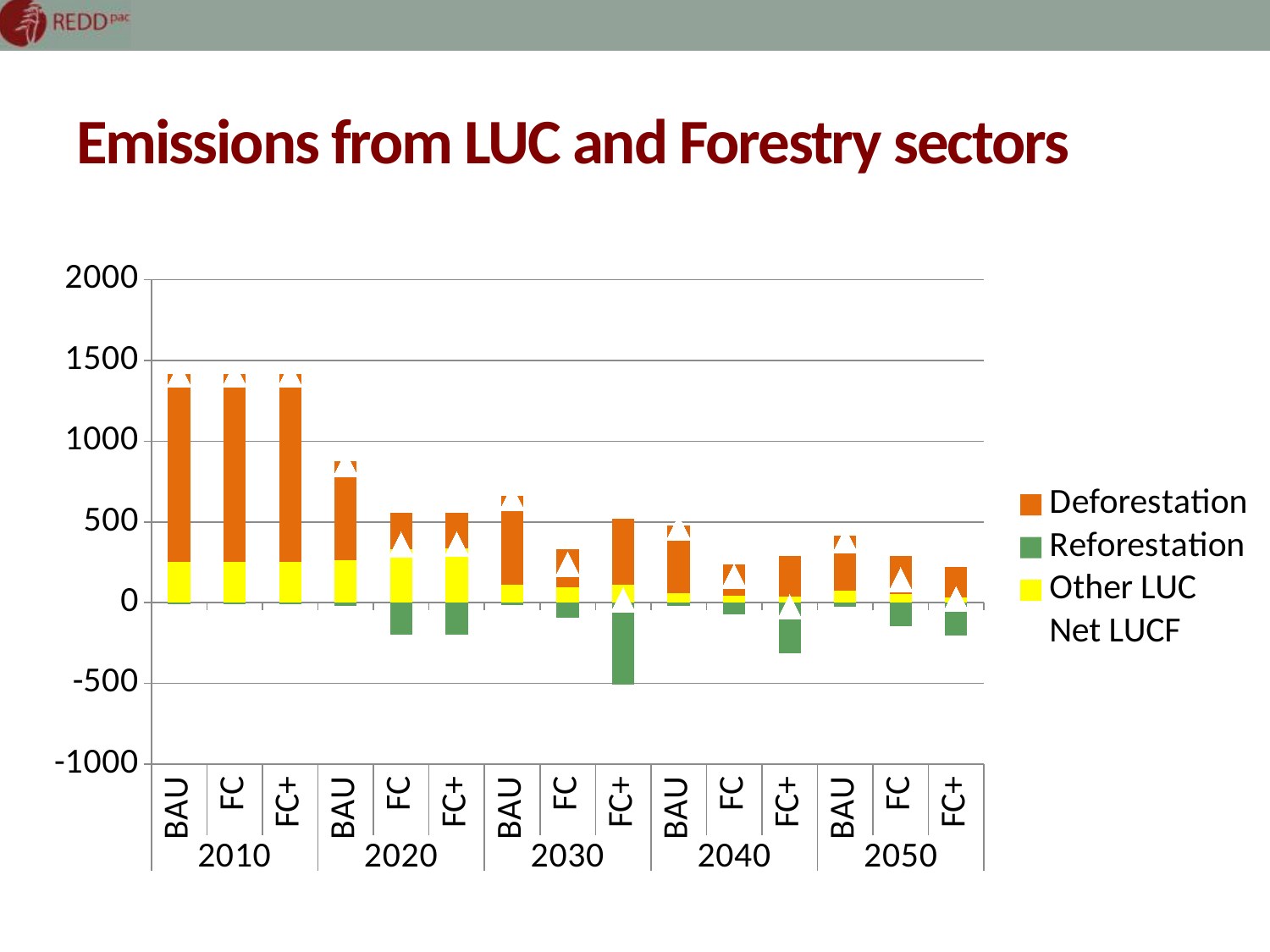
How many bars (scenario-year combinations) are plotted on the x axis? 15 What kind of chart is shown on the slide? Stacked bar chart What is the title of the chart? Emissions from LUC and Forestry sectors Do the BAU stacked bars rise or fall from 2010 to 2050? fall Is the Reforestation value for FC+ in 2030 greater or less than -250? less Is the top of the stacked bar for BAU in 2010 greater or less than 1000? greater Is the top of the stacked bar for FC+ in 2050 greater or less than 500? less In which year is the BAU stacked bar the tallest? 2010 How many years are shown along the x axis? 5 How many series does the legend list? 4 Which scenario-year bar has the largest negative Reforestation segment? FC+ in 2030